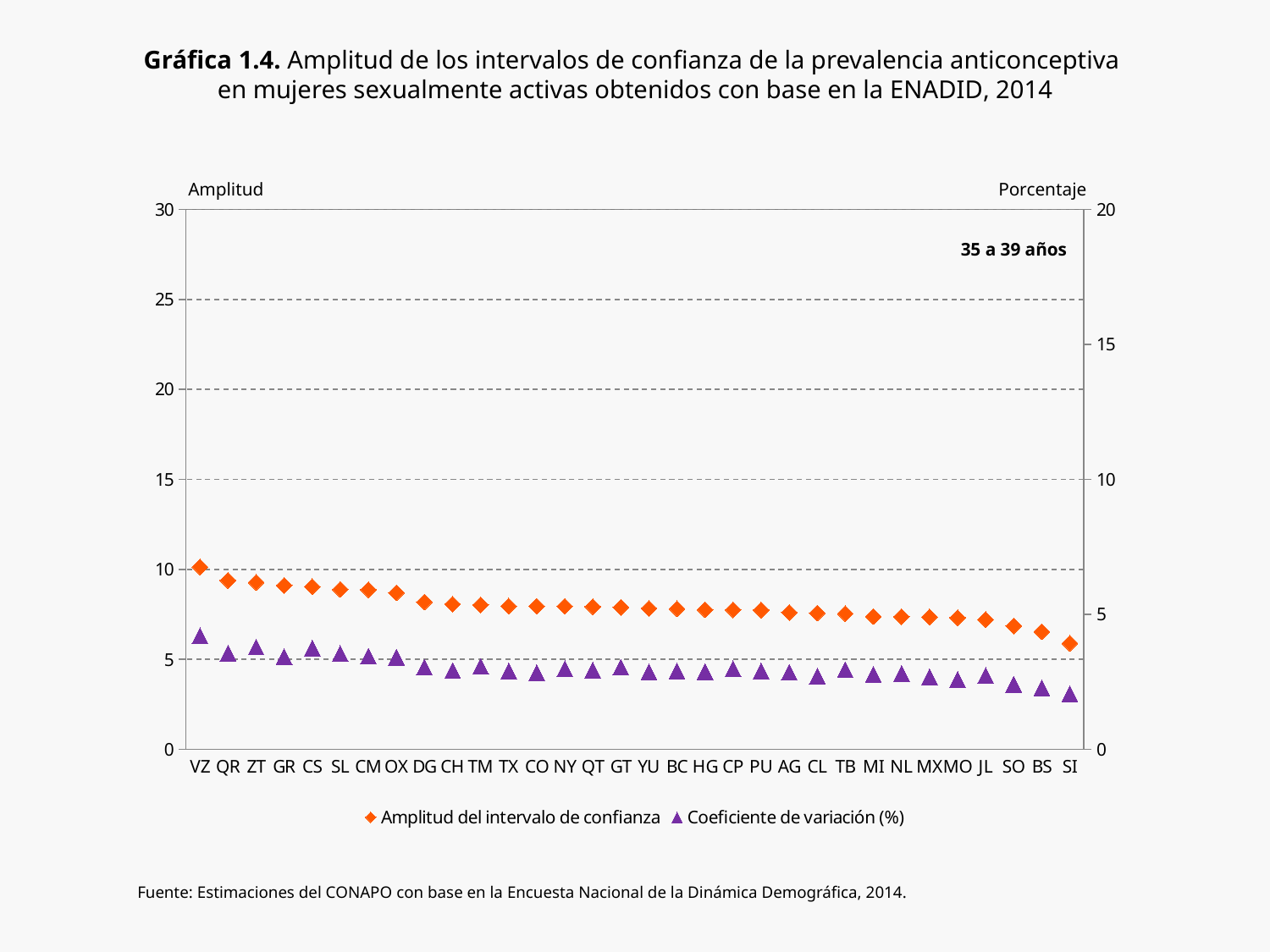
How many categories (states) are plotted along the x axis? 32 Which age group does the chart refer to, according to the label inside the plot area? 35 a 39 años Is the 'Amplitud del intervalo de confianza' value for VZ greater or less than 5? greater What is the title of the right-hand vertical axis? Porcentaje How many series does the legend list? 2 Which category has the highest value for 'Amplitud del intervalo de confianza'? VZ Is the 'Amplitud del intervalo de confianza' value for SI greater or less than 10? less Which category has the highest value for 'Coeficiente de variación (%)'? VZ Which is larger, the 'Amplitud del intervalo de confianza' for VZ or for SI? VZ Do the values for 'Amplitud del intervalo de confianza' rise or fall from left to right along the x axis? fall Which category has the lowest value for 'Amplitud del intervalo de confianza'? SI What kind of chart is shown on the slide? line chart